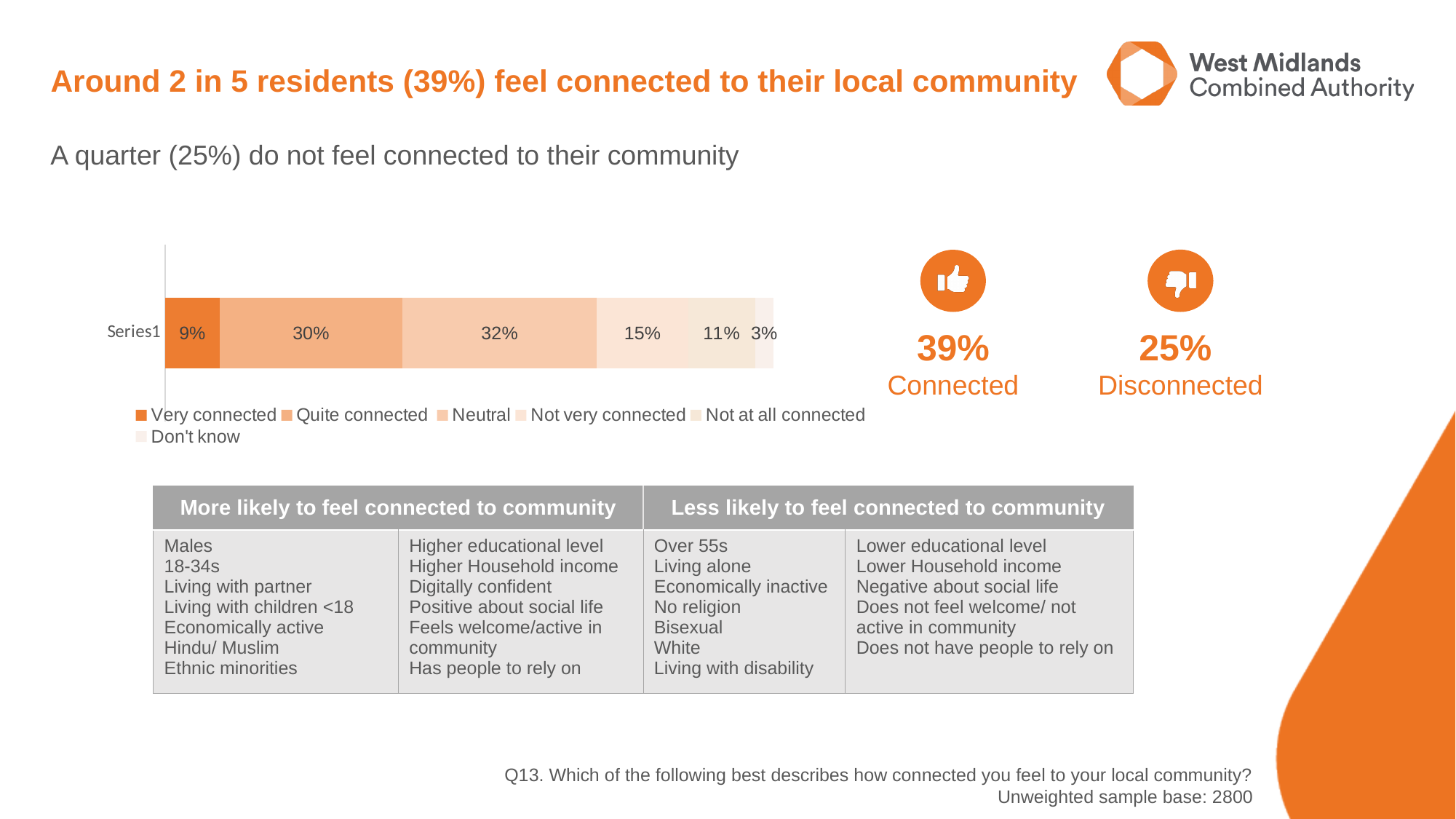
What is the difference between the 'Quite connected' and 'Very connected' values in the stacked bar chart? 21% What percentage of residents are 'Quite connected' in the stacked bar chart? 30% What percentage of residents are 'Very connected' according to the stacked bar chart? 9% Which segment of the stacked bar has the largest value? Neutral What type of chart is shown on the slide? Stacked bar chart Which segment of the stacked bar has the smallest value? Don't know Which is larger in the stacked bar chart: 'Not very connected' or 'Not at all connected'? Not very connected What is the value of the 'Don't know' segment in the stacked bar chart? 3% What percentage of residents are 'Not very connected' in the stacked bar chart? 15% What is the combined total of the 'Very connected' and 'Quite connected' segments in the stacked bar chart? 39% What is the value of the 'Neutral' segment in the stacked bar chart? 32% How many series does the legend of the stacked bar chart list? 6